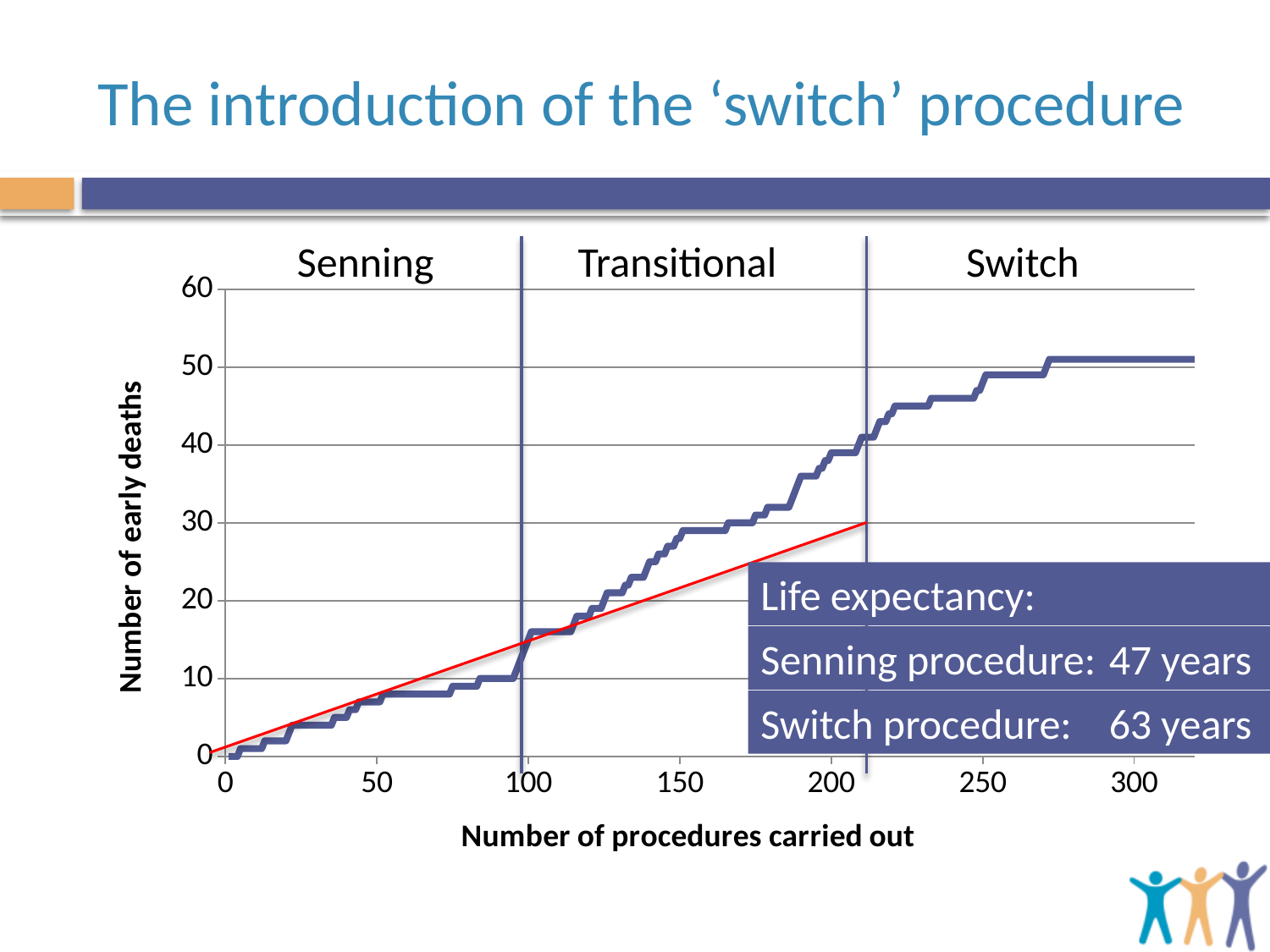
Is the number of early deaths at 150 procedures greater or less than 20? greater Is the number of early deaths at 50 procedures greater or less than 10? less What kind of chart is shown on the slide? line chart Is the number of early deaths at 200 procedures greater or less than 30? greater How many procedure phases are labelled across the top of the chart? 3 What is the label of the x axis? Number of procedures carried out Does the number of early deaths rise or fall as the number of procedures carried out increases? rise What is the label of the y axis? Number of early deaths